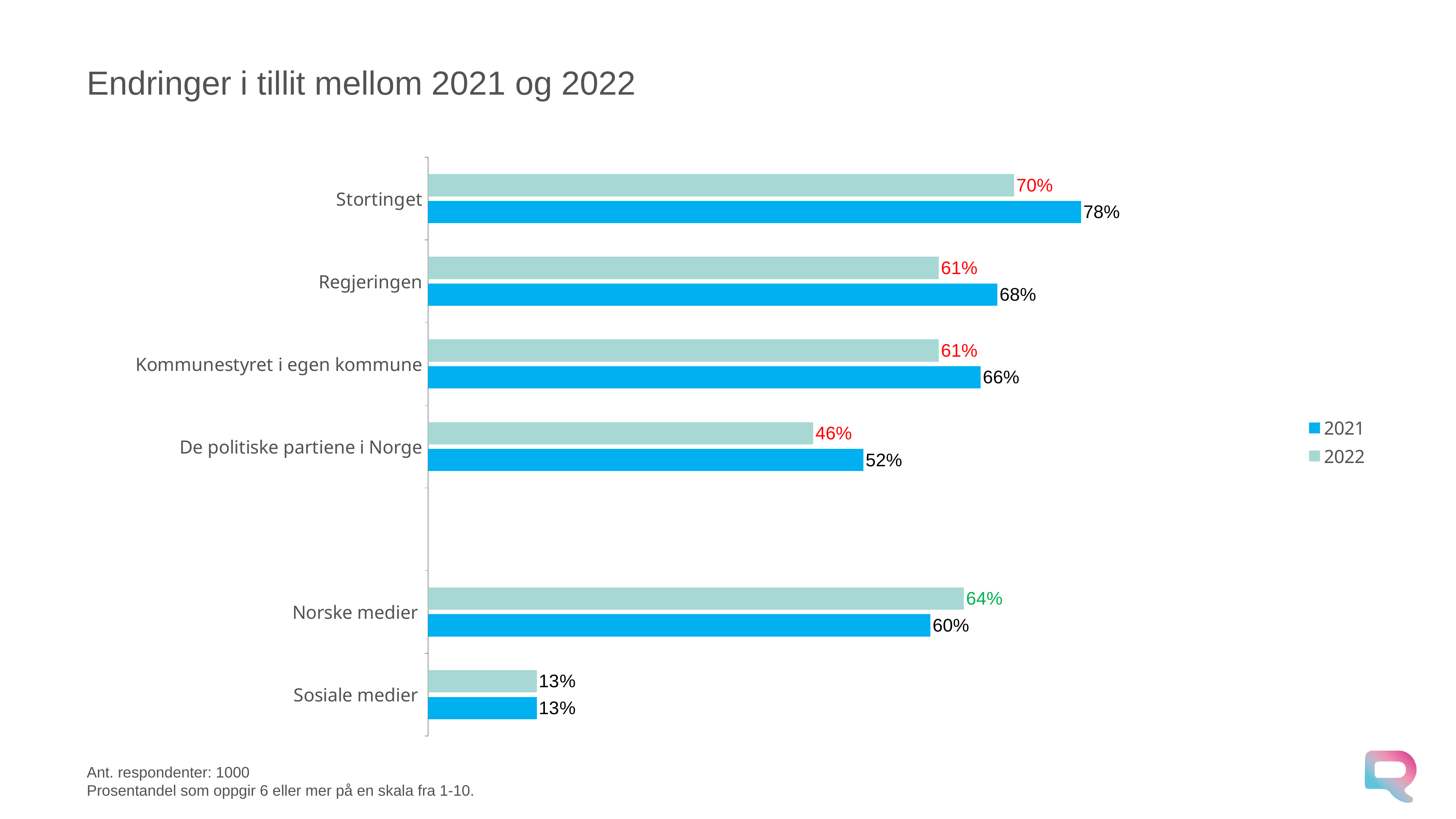
Which is larger for Norske medier, the 2021 value or the 2022 value? 2022 Which category has the highest 2021 value? Stortinget What is the difference between the 2021 and 2022 values for Stortinget? 8% What is the 2022 value for Norske medier? 64% What is the difference between the 2021 and 2022 values for Regjeringen? 7% What is the 2022 value for De politiske partiene i Norge? 46% What kind of chart is shown on the slide? Bar chart How many series does the legend list? 2 What is the 2021 value for Stortinget? 78% What is the title of the slide? Endringer i tillit mellom 2021 og 2022 Which category has the lowest 2022 value? Sosiale medier How many categories are labelled on the chart? 6